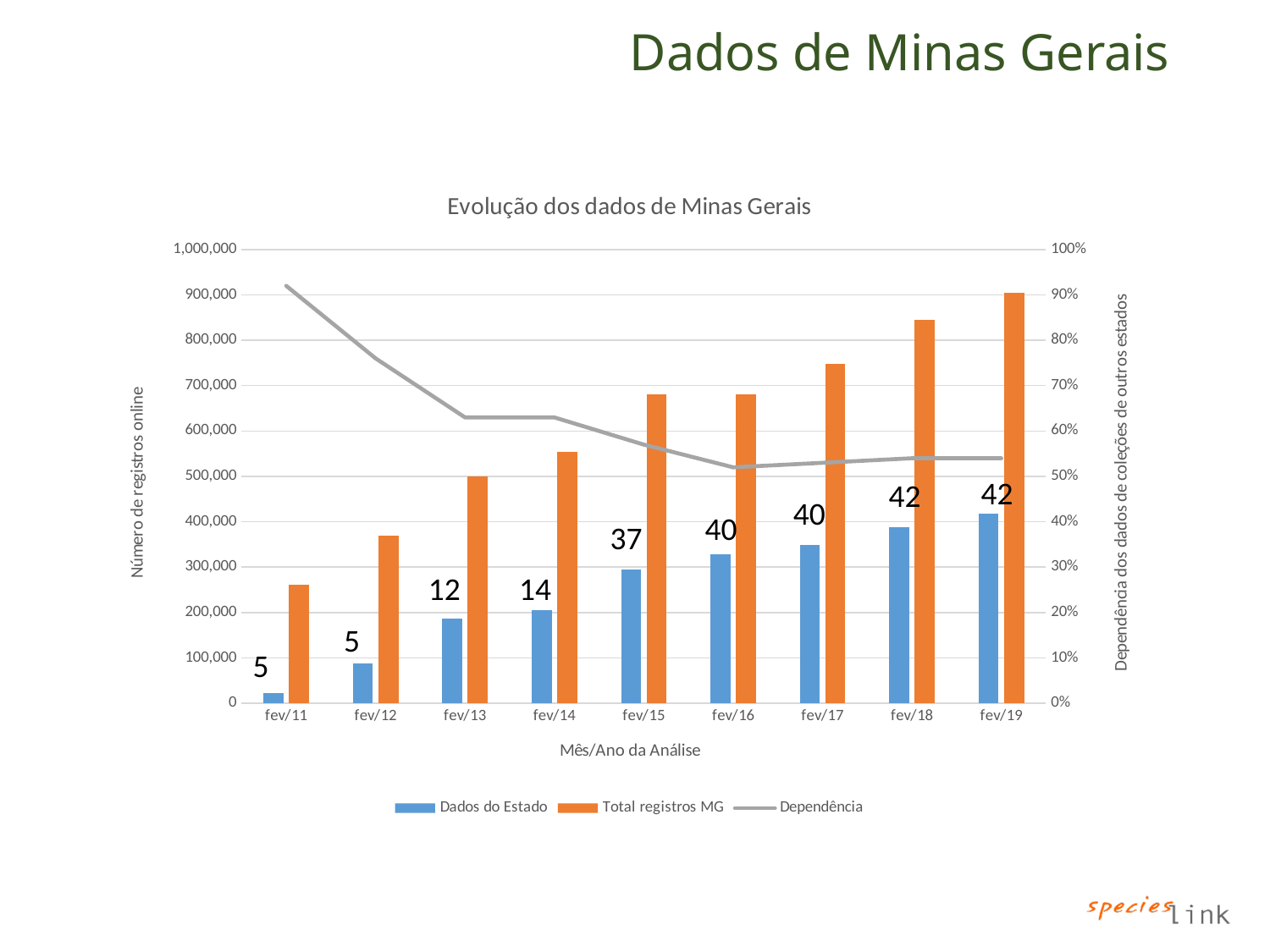
At which month/year is the Dados do Estado bar lowest? fev/11 Which is larger, the Total registros MG bar for fev/17 or for fev/18? fev/18 What is the title of the chart? Evolução dos dados de Minas Gerais At which month/year is the Total registros MG bar highest? fev/19 Is the Total registros MG value for fev/18 greater or less than 800,000? greater Which series is drawn as a line rather than bars? Dependência Does the Total registros MG series rise or fall from fev/11 to fev/19? Rise What kind of chart is this? Combination bar and line chart How many time points are shown on the x axis? 9 Does the Dependência line generally rise or fall from fev/11 to fev/16? Fall Is the Dados do Estado value for fev/13 greater or less than 200,000? less How many series does the chart legend list? 3